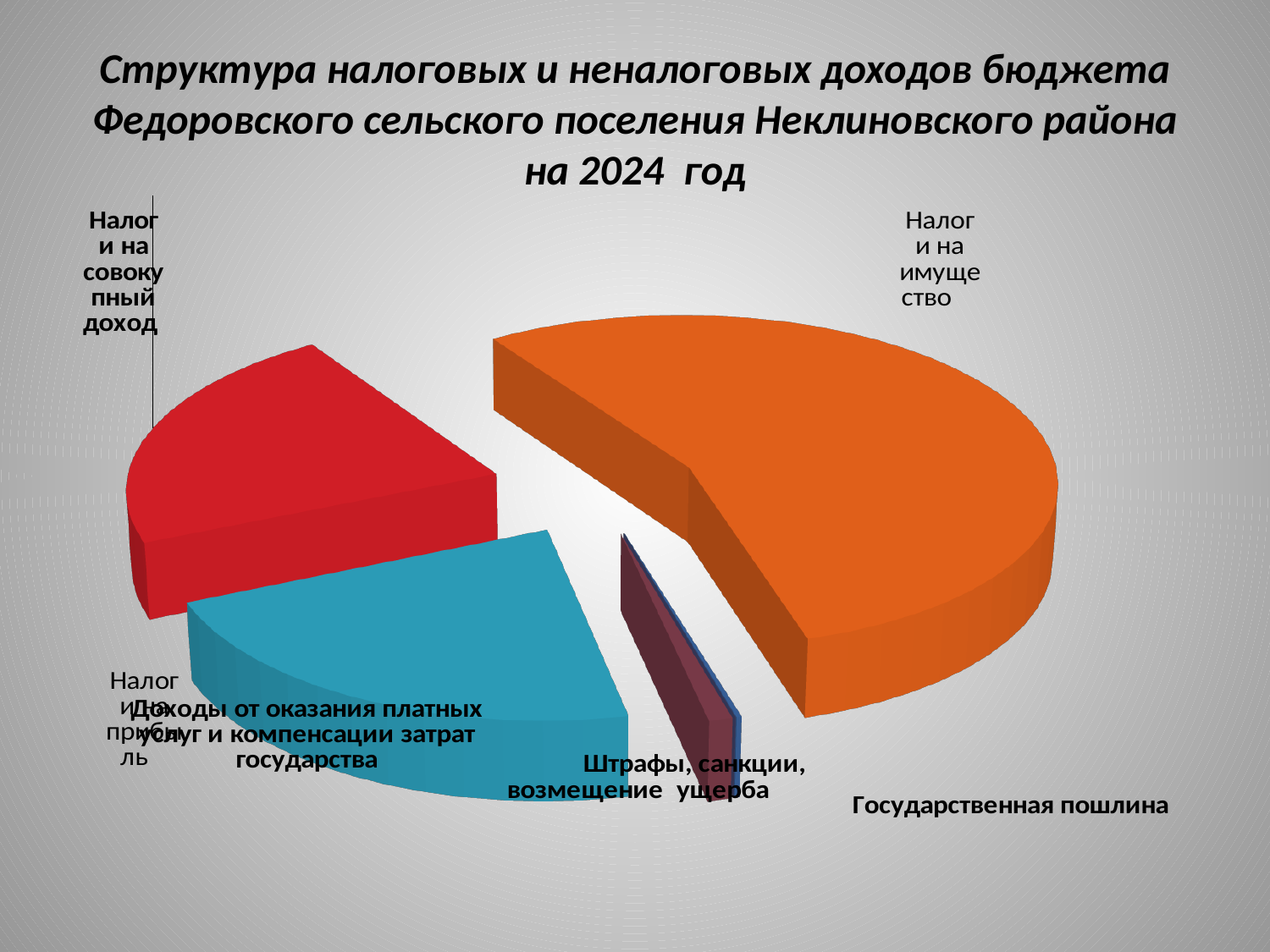
Which slice is larger: Налоги на имущество or Налоги на совокупный доход? Налоги на имущество What colour is the slice for Налоги на имущество? orange Which slice is larger: Доходы от оказания платных услуг и компенсации затрат государства or Штрафы, санкции, возмещение ущерба? Доходы от оказания платных услуг и компенсации затрат государства What colour is the slice for Налоги на совокупный доход? red What kind of chart is shown on the slide? pie chart How many categories are labelled on the pie chart? 6 Which category has the largest slice of the pie? Налоги на имущество Which slice is larger: Налоги на совокупный доход or Штрафы, санкции, возмещение ущерба? Налоги на совокупный доход